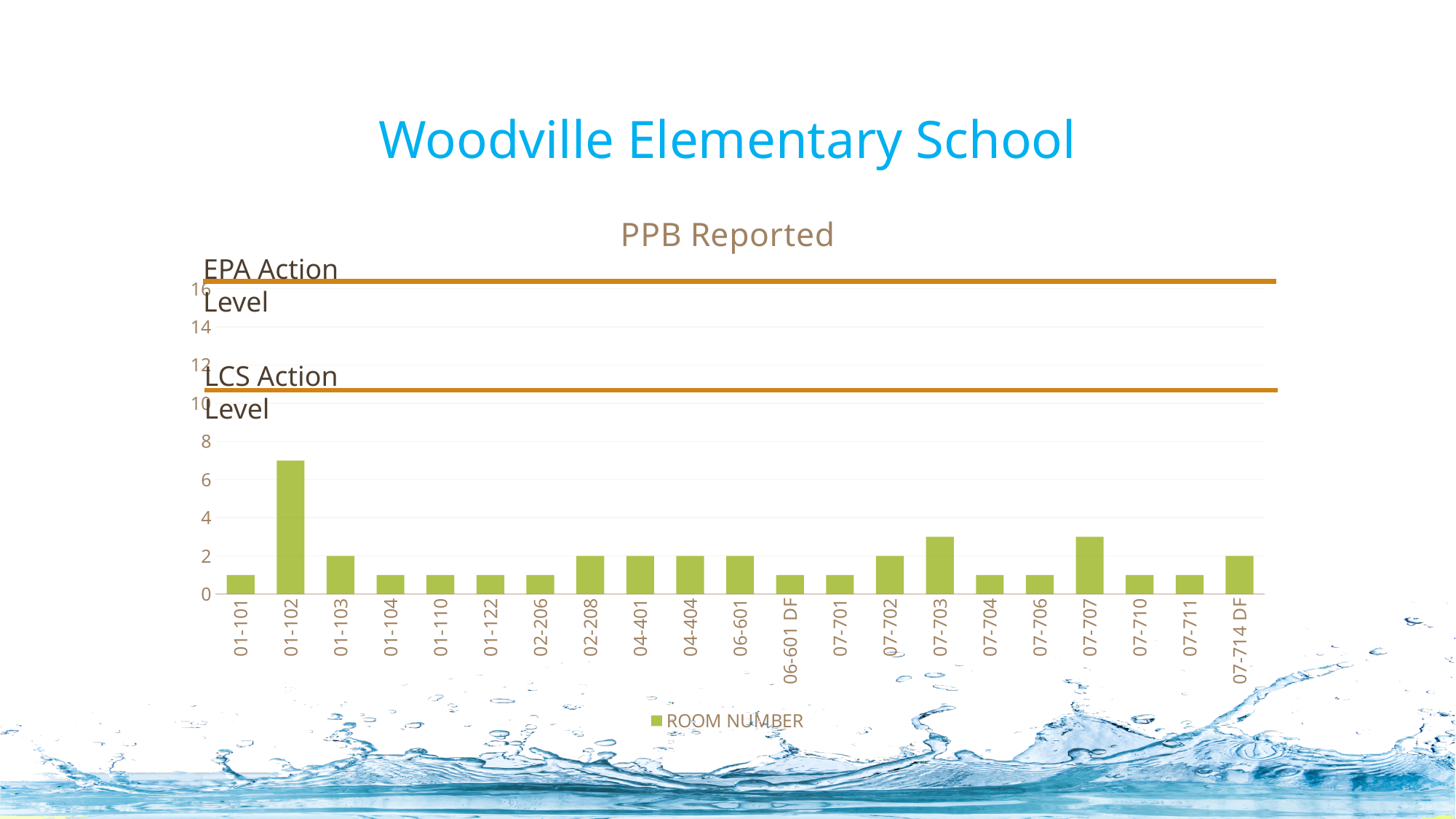
Which has a larger value, 07-703 or 07-704? 07-703 Is the value for 07-707 greater or less than 2? greater What is the legend entry for the bars? ROOM NUMBER How many room numbers are shown on the x axis of the chart? 21 Which room number has the highest PPB reported value? 01-102 Is the value for 01-102 greater or less than 8? less How many series does the legend list? 1 Which has a larger value, 01-102 or 07-703? 01-102 What type of chart is shown on the slide? bar chart Is the value for 01-102 greater or less than 6? greater What is the title of the chart? PPB Reported